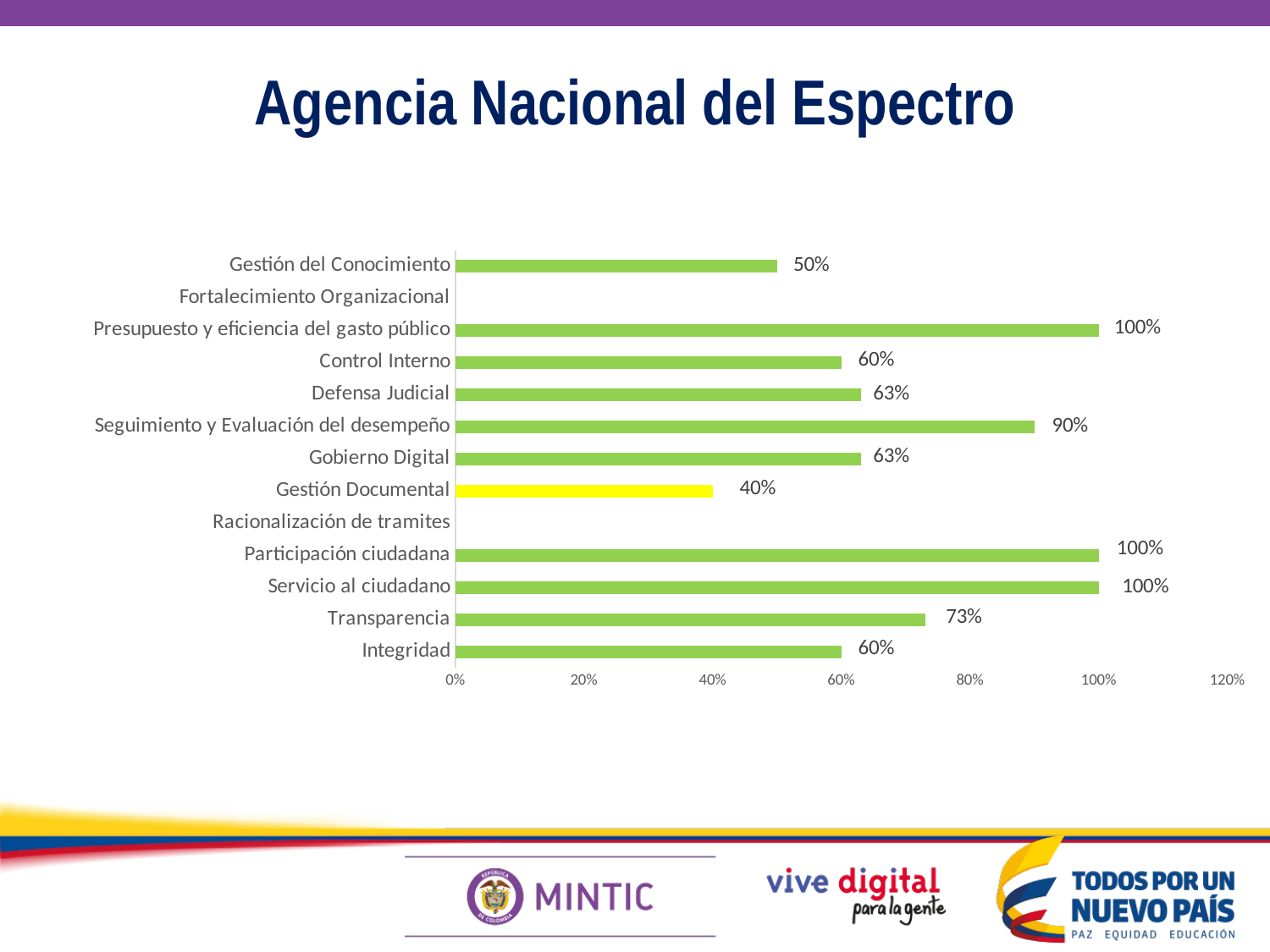
What kind of chart is shown on the slide? Bar chart What is the value for Gestión Documental? 40% Which category's bar is coloured yellow instead of green? Gestión Documental What is the value for Transparencia? 73% What is the highest value shown on the chart? 100% What is the value for Seguimiento y Evaluación del desempeño? 90% What is the value for Gestión del Conocimiento? 50% Which category has the lowest plotted value? Gestión Documental What is the difference between the values for Seguimiento y Evaluación del desempeño and Gestión Documental? 50% Which is larger, the value for Transparencia or the value for Defensa Judicial? Transparencia How many category labels are listed on the vertical axis? 13 What is the value for Control Interno? 60%